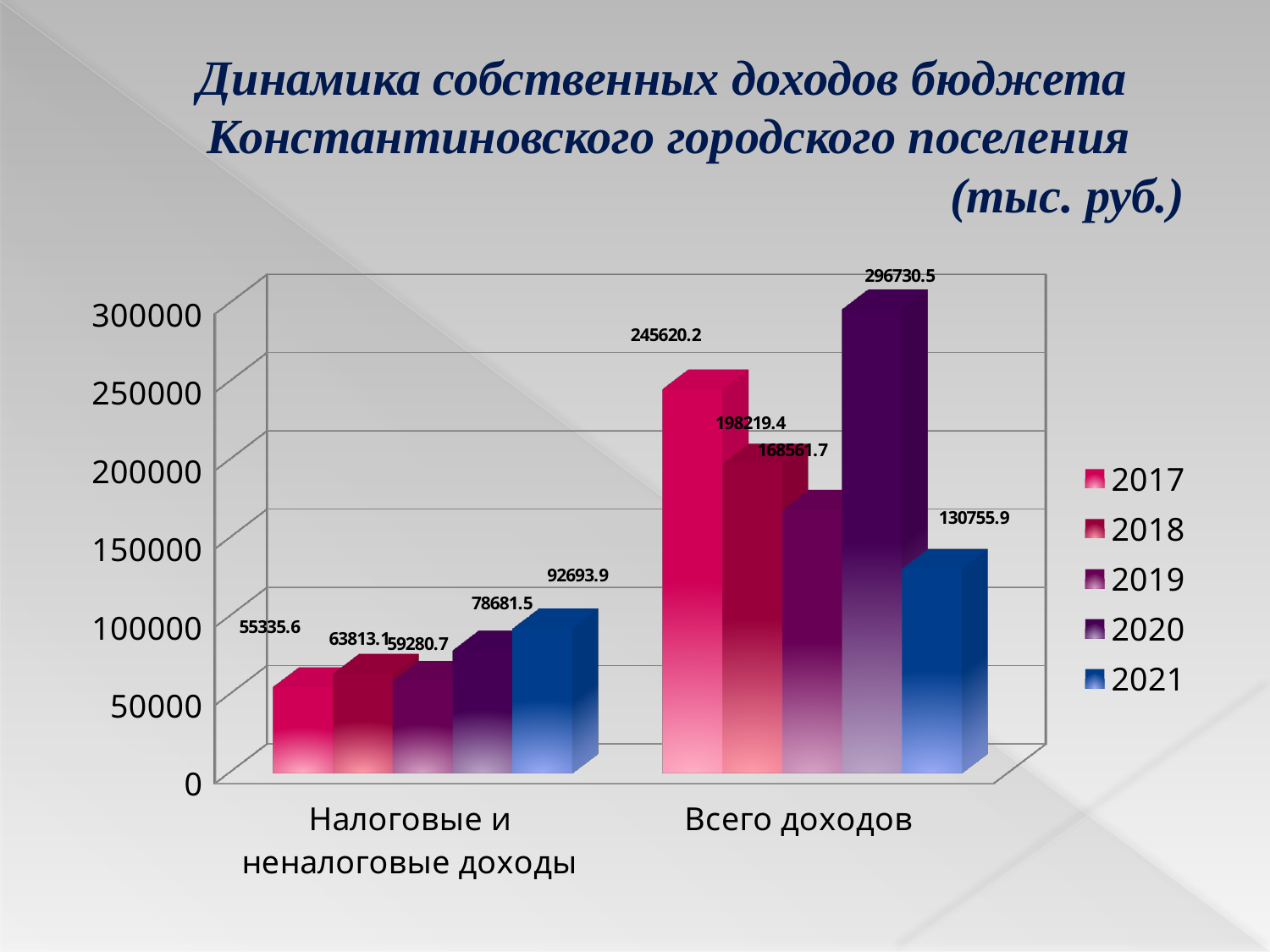
Which year has the lowest value in the 'Всего доходов' category? 2021 Which year has the lowest value in the 'Налоговые и неналоговые доходы' category? 2017 In the 'Всего доходов' category, which is larger: the value for 2018 or the value for 2019? 2018 What kind of chart is shown on the slide? Bar chart What is the difference between the 2021 and 2017 values in the 'Налоговые и неналоговые доходы' category? 37358.3 Which year has the highest value in the 'Всего доходов' category? 2020 What is the difference between the 2020 and 2021 values in the 'Всего доходов' category? 165974.6 What is the value for 2020 in the 'Всего доходов' category? 296730.5 How many series does the legend list? 5 What is the value for 2019 in the 'Налоговые и неналоговые доходы' category? 59280.7 What is the value for 2017 in the 'Всего доходов' category? 245620.2 What is the value for 2021 in the 'Налоговые и неналоговые доходы' category? 92693.9